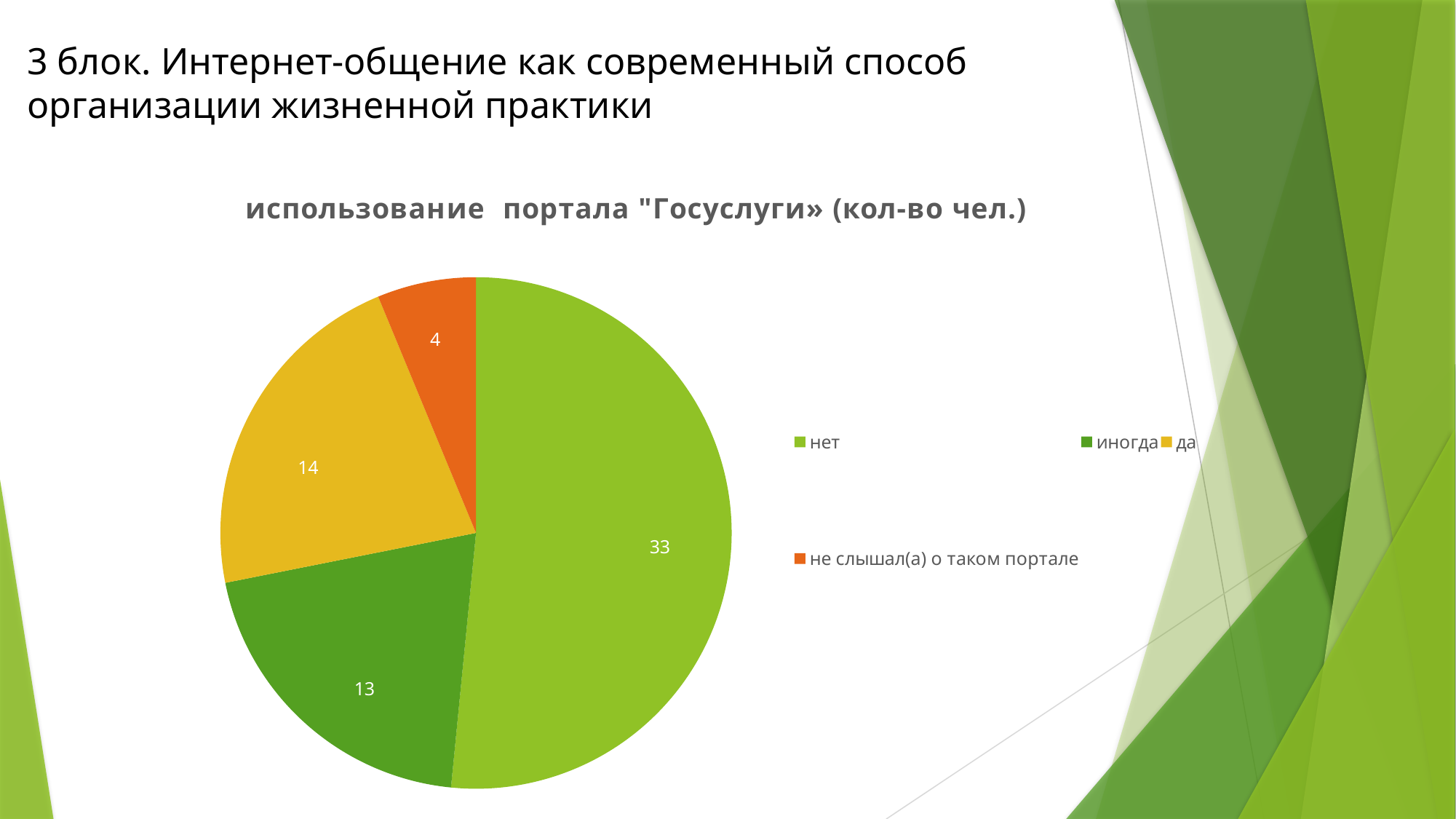
Which is larger, the value for "да" or the value for "иногда"? да Which category has the largest slice? нет How many slices does the pie chart have? 4 Which category has the smallest slice? не слышал(а) о таком портале What is the difference between the values for "нет" and "да"? 19 What is the value for "не слышал(а) о таком портале"? 4 What kind of chart is shown on the slide? pie chart What is the value for "иногда"? 13 What is the total of all slices in the pie chart? 64 What is the value for "да"? 14 What is the value for "нет"? 33 What is the title of the chart? использование портала "Госуслуги» (кол-во чел.)